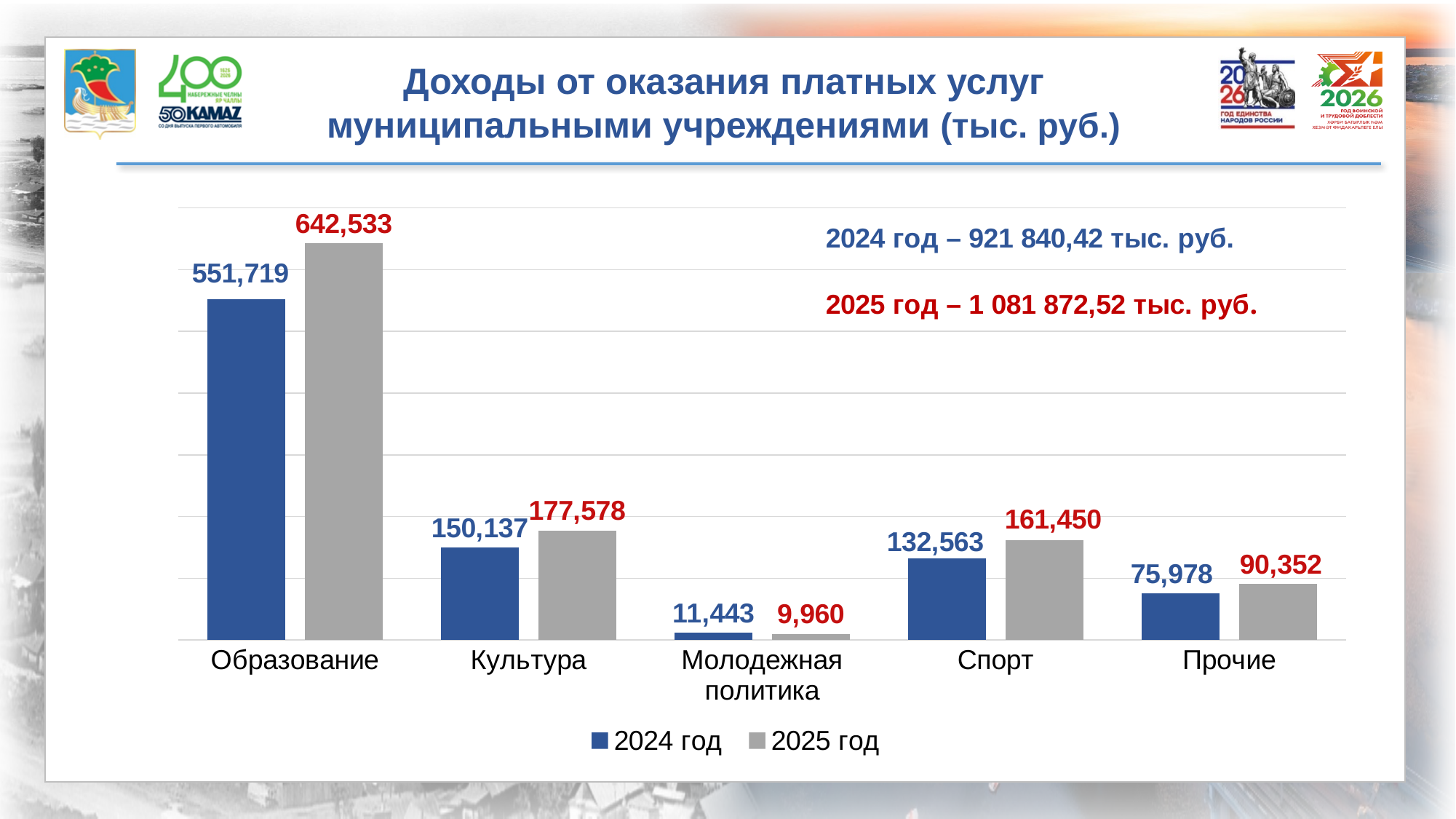
What is the value for Молодежная политика in the 2025 год series? 9,960 How many categories are shown on the x axis of the chart? 5 For Молодежная политика, which is larger: the 2024 год value or the 2025 год value? 2024 год What is the value for Образование in the 2025 год series? 642,533 What type of chart is shown on the slide? bar chart What is the difference between the 2025 год and 2024 год values for Прочие? 14,374 What is the value for Спорт in the 2024 год series? 132,563 How many series does the chart legend list? 2 What is the difference between the 2025 год and 2024 год values for Культура? 27,441 Which category has the lowest value in the 2025 год series? Молодежная политика Which colour represents the 2025 год series in the chart? grey Which category has the highest value in the 2024 год series? Образование